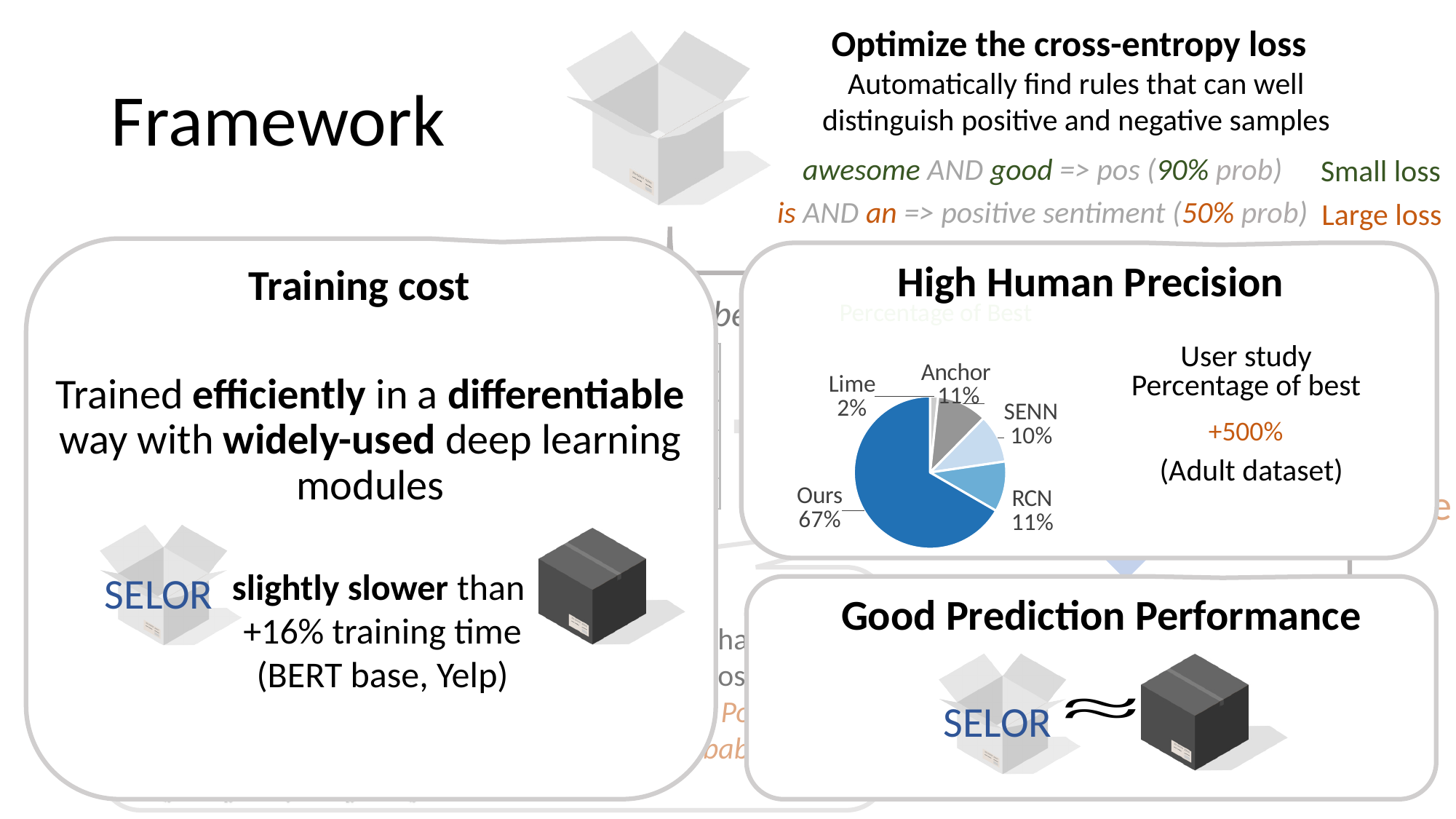
Which method has the largest slice in the pie chart? Ours Which method has the smallest slice in the pie chart? Lime In the pie chart, what percentage is shown for SENN? 10% What dataset is named next to the pie chart in the High Human Precision panel? Adult dataset In the pie chart, what is the difference in percentage points between Ours and RCN? 56 How many slices does the pie chart have? 5 In the pie chart, what percentage is shown for RCN? 11% In the pie chart, which is larger, the share for Anchor or the share for SENN? Anchor In the pie chart, what percentage is shown for Lime? 2% In the pie chart, what percentage is shown for Anchor? 11% What kind of chart is shown in the High Human Precision panel? pie chart In the pie chart, what percentage is shown for Ours? 67%